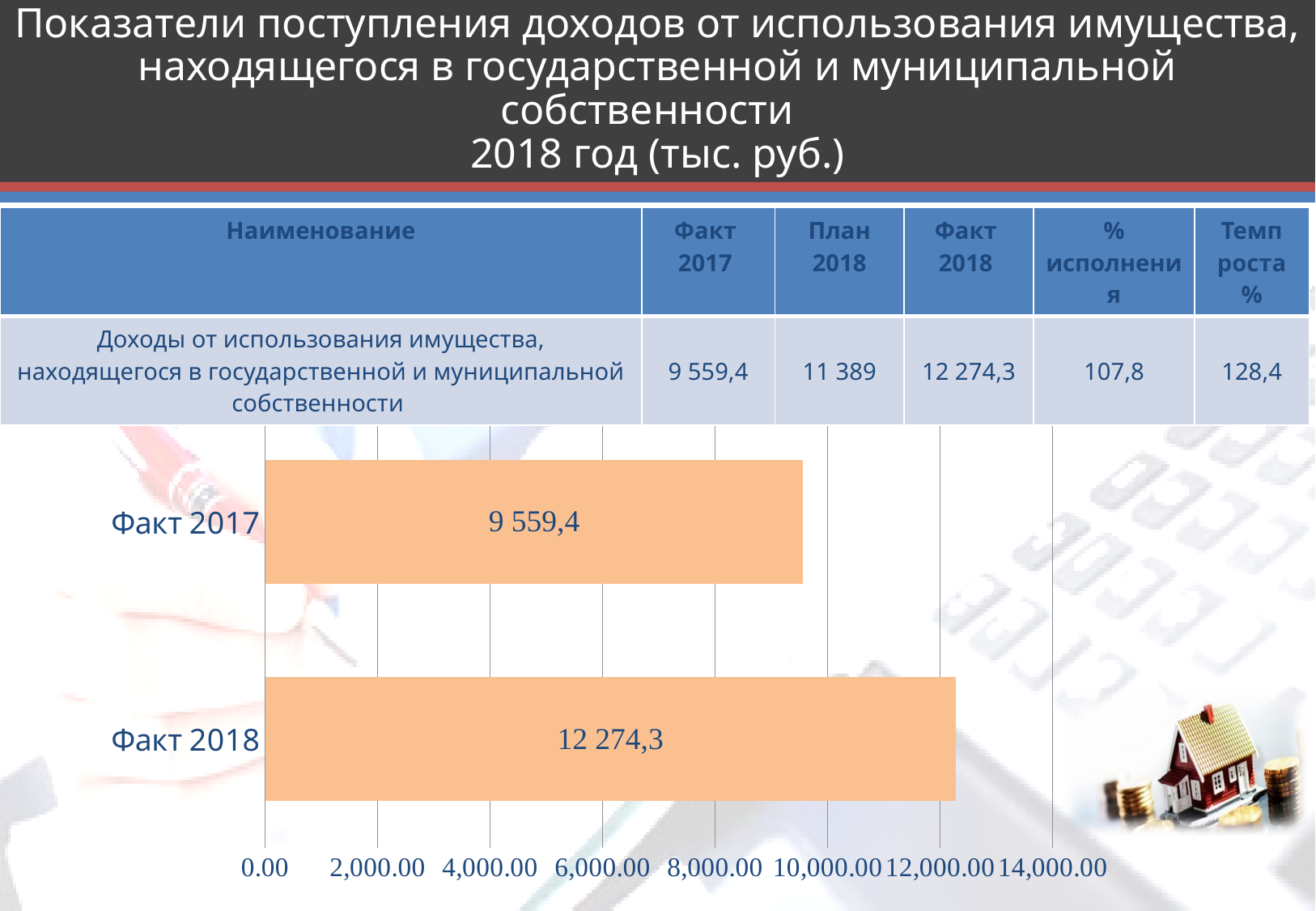
What is the value of the bar for Факт 2018? 12 274,3 What is the difference between the values for Факт 2018 and Факт 2017? 2 714,9 Is the value for Факт 2017 greater or less than 10,000.00? less Does the value rise or fall from Факт 2017 to Факт 2018? rise Which category has the lowest value in the chart? Факт 2017 What is the value of the bar for Факт 2017? 9 559,4 How many bars are shown in the chart? 2 What is the highest tick value shown on the chart's value axis? 14,000.00 Is the value for Факт 2018 greater or less than 12,000.00? greater What kind of chart is shown on the slide? bar chart Which category has the highest value in the chart? Факт 2018 Which is larger, the value for Факт 2017 or the value for Факт 2018? Факт 2018